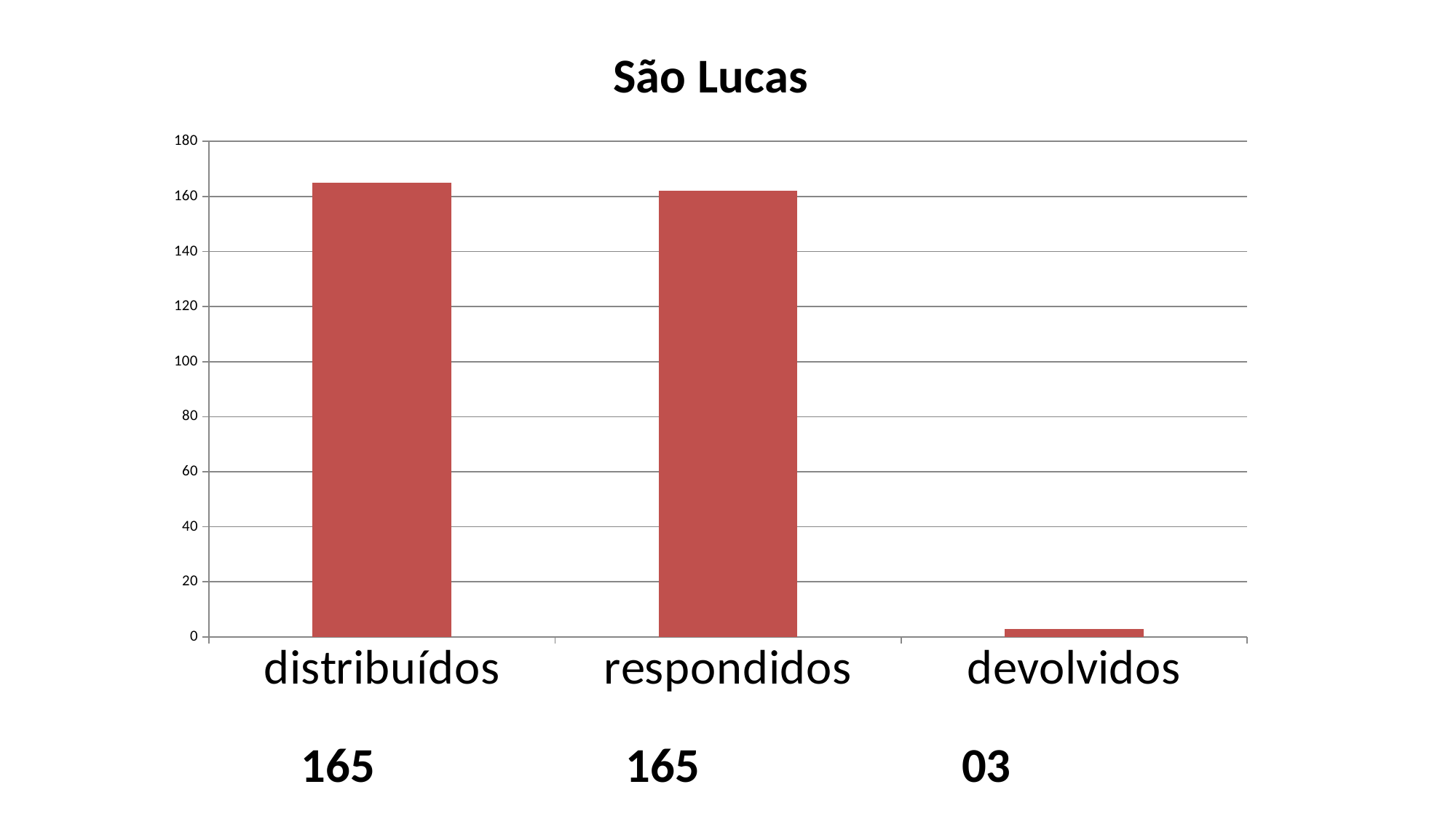
What value is printed for distribuídos? 165 Which category has the lowest bar? devolvidos Is the value for respondidos greater or less than 140? greater What is the difference between the printed values for distribuídos and devolvidos? 162 What is the title of the chart? São Lucas Which is larger, the bar for respondidos or the bar for devolvidos? respondidos How many categories are shown on the x axis of the chart? 3 Is the value for distribuídos greater or less than 160? greater What kind of chart is shown on the slide? bar chart Is the value for devolvidos greater or less than 20? less What value is printed for devolvidos? 03 What colour are the bars in the chart? red